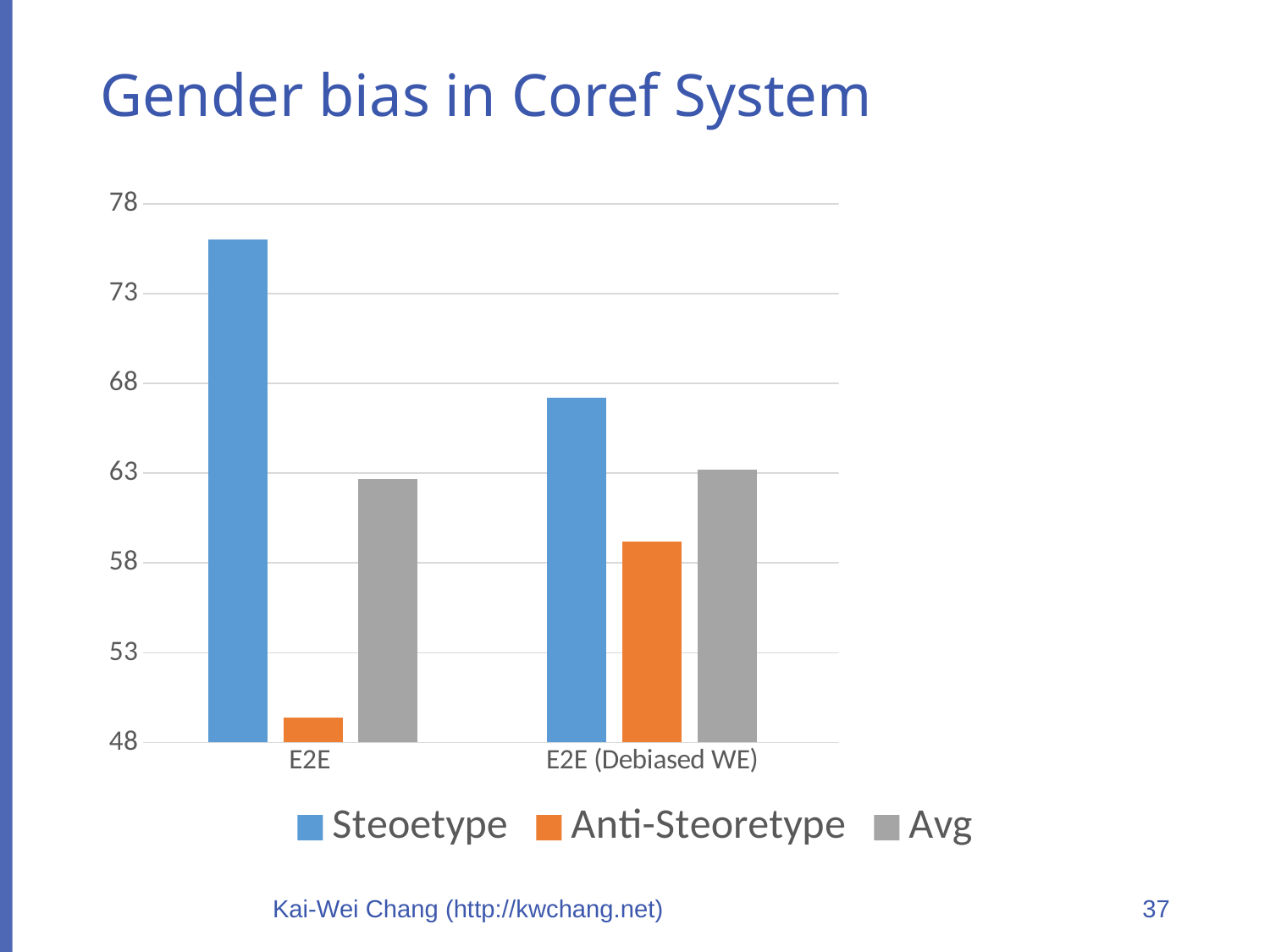
What kind of chart is shown on the slide? bar chart Which category has the larger Anti-Steoretype value, E2E or E2E (Debiased WE)? E2E (Debiased WE) Which category has the larger Steoetype value, E2E or E2E (Debiased WE)? E2E Which bar is the tallest in the whole chart? Steoetype for E2E Is the Anti-Steoretype value for E2E (Debiased WE) greater or less than 58? greater Is the Steoetype value for E2E greater or less than 73? greater Is the Anti-Steoretype value for E2E greater or less than 53? less Which series has the highest bar in the E2E category? Steoetype Which series has the lowest bar in the E2E category? Anti-Steoretype How many series does the legend list? 3 What colour represents the Anti-Steoretype series in the legend? orange How many categories are shown on the x axis? 2